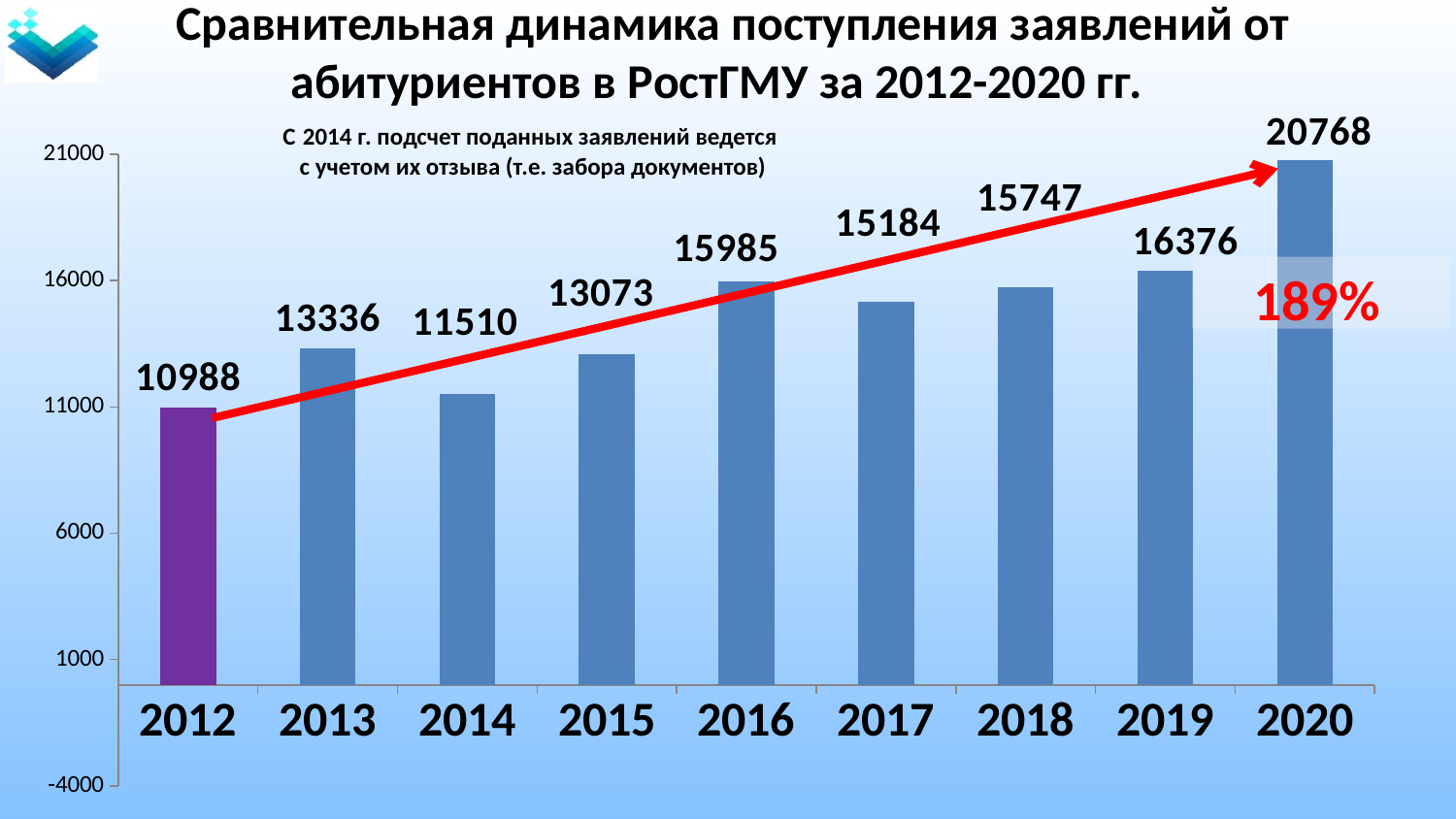
Which is larger, the value for 2017 or the value for 2018? 2018 What percentage is printed in red next to the 2020 bar? 189% How many years are shown on the x axis? 9 What is the difference between the values for 2020 and 2012? 9780 What is the value for 2020? 20768 What is the value for 2016? 15985 What is the difference between the values for 2013 and 2014? 1826 What is the value for 2012? 10988 What kind of chart is shown on the slide? bar chart Which year has the lowest value? 2012 Which year has the highest value? 2020 Is the value for 2019 greater or less than 16000? greater